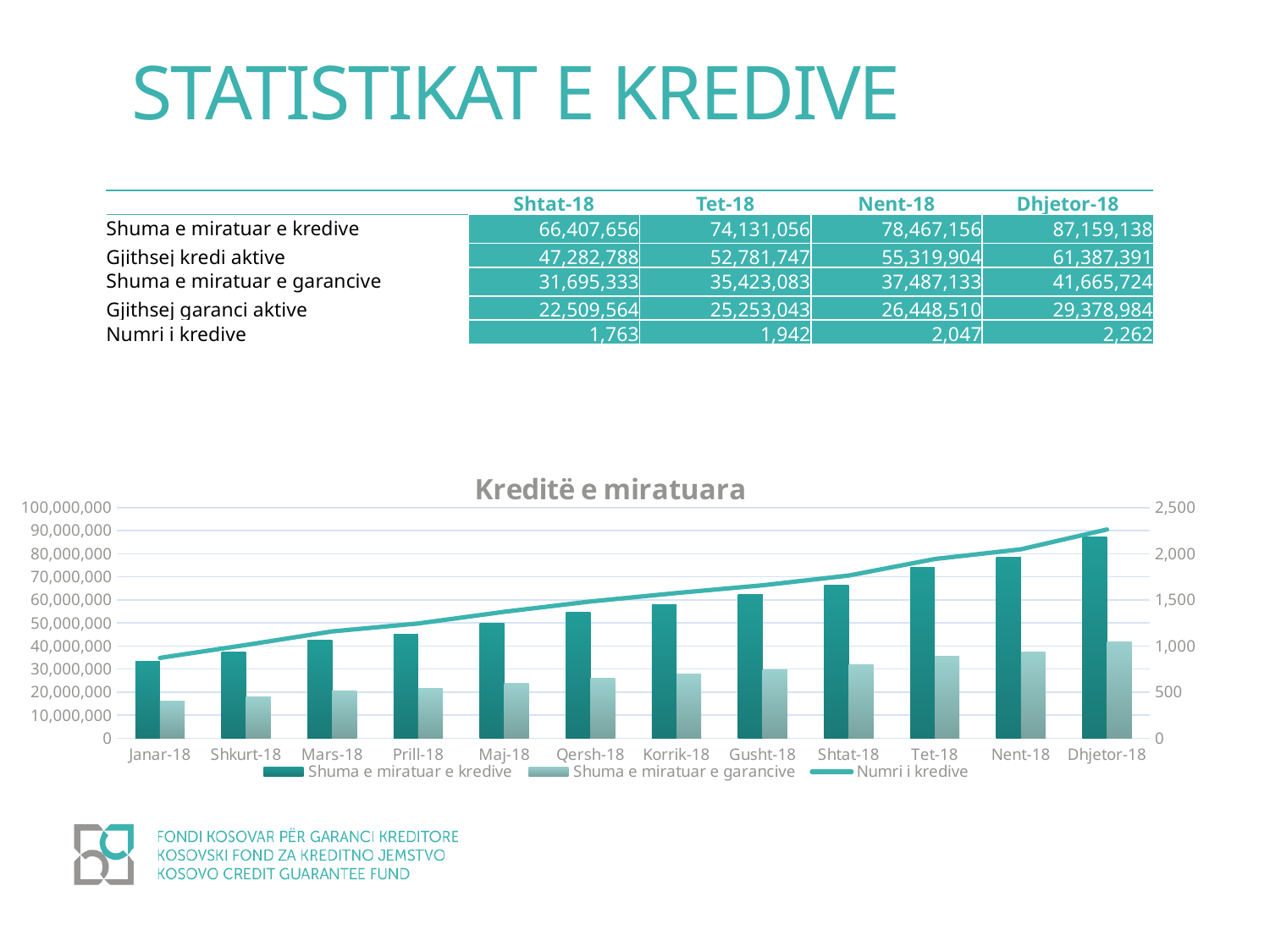
How many series does the legend of the "Kreditë e miratuara" chart list? 3 In Shtat-18, which is larger: Shuma e miratuar e kredive or Shuma e miratuar e garancive? Shuma e miratuar e kredive How many months are shown on the x axis of the "Kreditë e miratuara" chart? 12 In the "Kreditë e miratuara" chart, is the value for Shuma e miratuar e garancive in Janar-18 greater or less than 20,000,000? less According to the table, what is the value of Numri i kredive for Dhjetor-18? 2,262 According to the table, what is the value of Shuma e miratuar e kredive for Dhjetor-18? 87,159,138 Using the table values, what is the difference in Shuma e miratuar e kredive between Dhjetor-18 and Shtat-18? 20,751,482 In the "Kreditë e miratuara" chart, which month has the lowest value for Shuma e miratuar e garancive? Janar-18 In the "Kreditë e miratuara" chart, which month has the highest value for Shuma e miratuar e kredive? Dhjetor-18 In the "Kreditë e miratuara" chart, does Shuma e miratuar e kredive rise or fall from Janar-18 to Dhjetor-18? rise What kind of chart is shown under the title "Kreditë e miratuara"? bar chart with a line In the "Kreditë e miratuara" chart, is the value for Shuma e miratuar e kredive in Janar-18 greater or less than 40,000,000? less